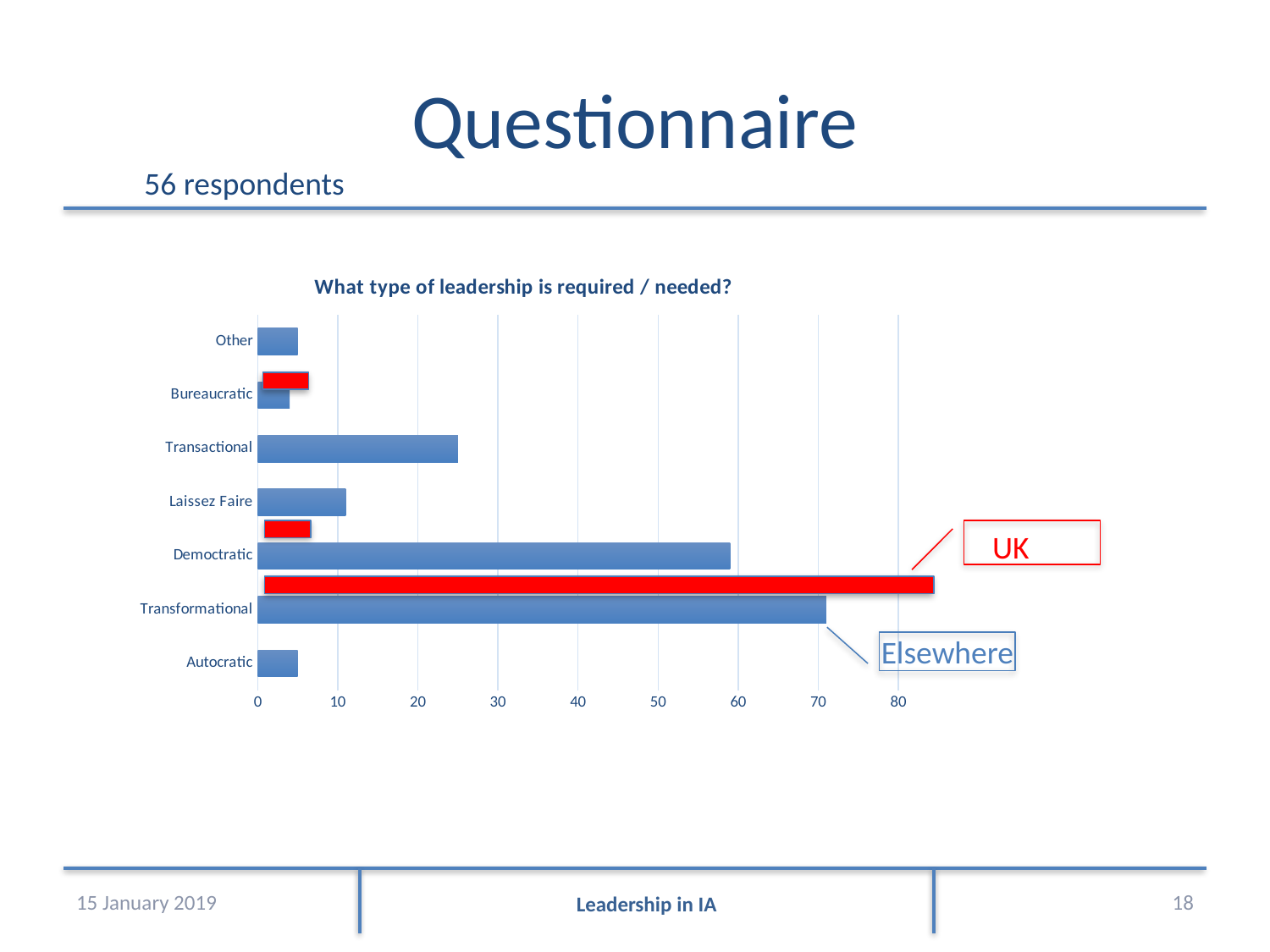
Is the UK value for Transformational greater or less than 80? greater Which leadership type has the longest bar on the chart? Transformational Is the Elsewhere value for Transactional greater or less than 30? less Is the Elsewhere value for Laissez Faire greater or less than 20? less For Transformational leadership, which bar is longer, UK or Elsewhere? UK What kind of chart is shown on the slide? Bar chart How many leadership categories are listed on the chart's vertical axis? 7 Which two groups are the bars labelled as on the chart? UK and Elsewhere What is the title of the chart? What type of leadership is required / needed? Which has the larger Elsewhere value, Democratic or Transactional? Democratic Which has the larger Elsewhere value, Transactional or Laissez Faire? Transactional